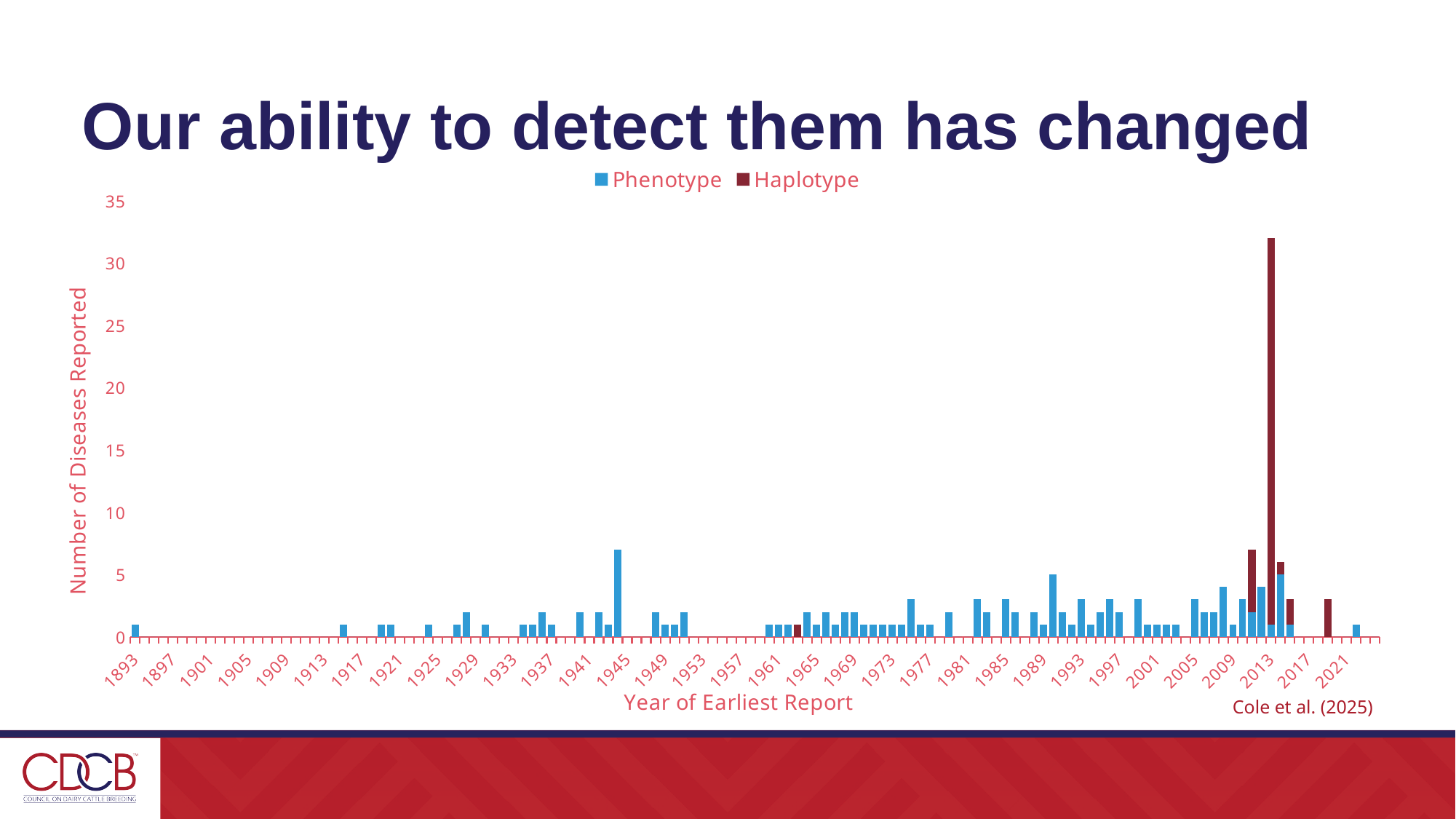
Do the Haplotype bars appear mostly before or after 2009 on the x axis? after What are the two series named in the legend? Phenotype and Haplotype Is the value for 1961 greater or less than 5? less Is the tallest bar on the chart greater or less than 25? greater What is the title of the vertical axis? Number of Diseases Reported How many series does the legend list? 2 What kind of chart is shown on the slide? Bar chart Is the value for 1893 greater or less than 5? less Which series does the tallest bar on the chart belong to? Haplotype